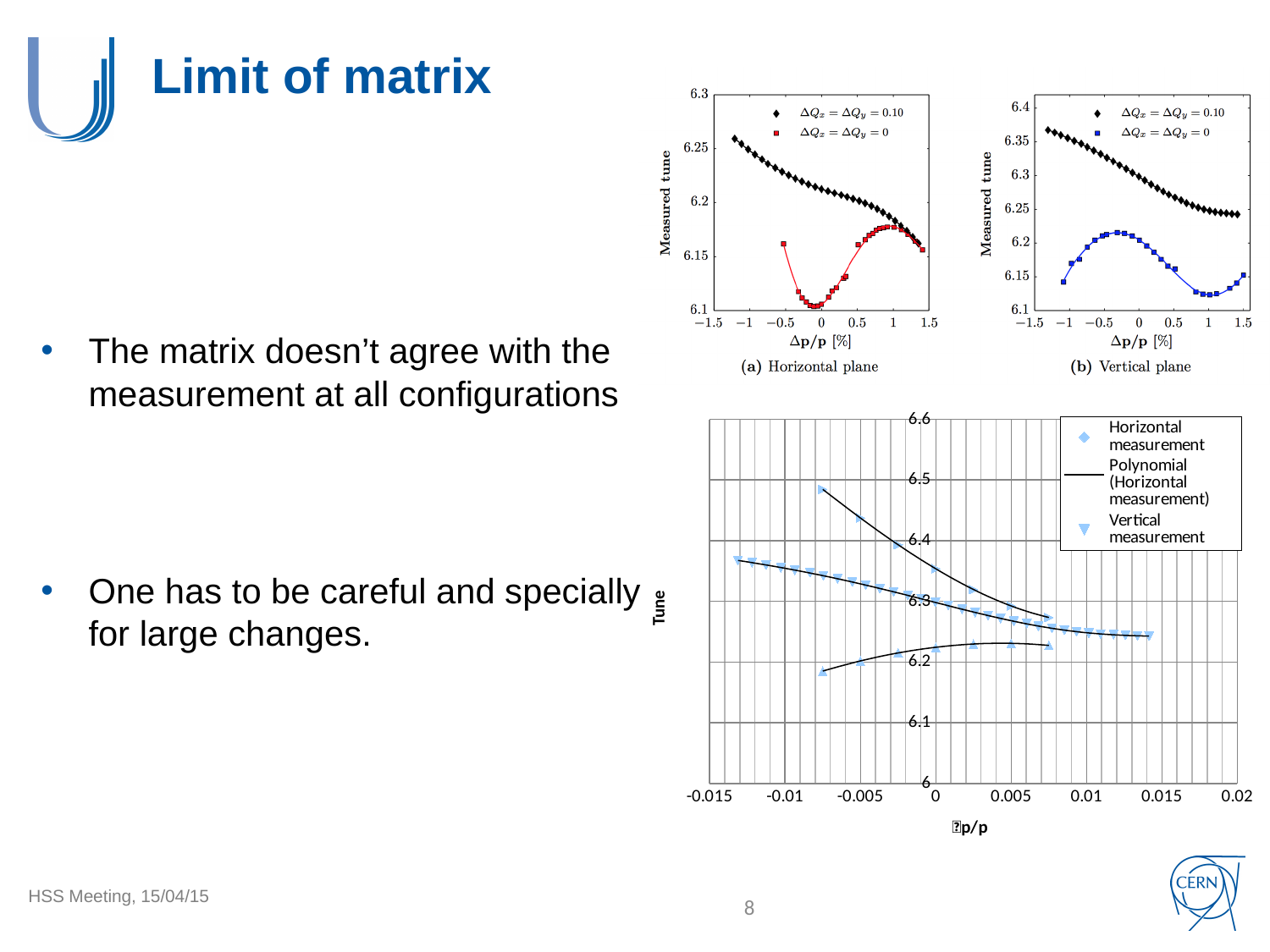
In chart (b) Vertical plane, at Δp/p = 0, which series has the higher measured tune: ΔQx = ΔQy = 0.10 or ΔQx = ΔQy = 0? ΔQx = ΔQy = 0.10 In chart (a) Horizontal plane, does the ΔQx = ΔQy = 0.10 series rise or fall as Δp/p increases? fall In chart (b) Vertical plane, is the peak value of the ΔQx = ΔQy = 0 series greater or less than 6.25? less How many series does the legend of the bottom-right chart list? 3 What kind of chart is the large chart at the bottom right of the slide? scatter chart What is the y-axis label of the bottom-right chart? Tune What is the y-axis label of the two small charts at the top right of the slide? Measured tune In chart (b) Vertical plane, does the ΔQx = ΔQy = 0.10 series rise or fall as Δp/p increases? fall How many series does the legend of chart (a) Horizontal plane list? 2 In chart (a) Horizontal plane, is the value of the ΔQx = ΔQy = 0.10 series at Δp/p = -1 greater or less than 6.2? greater